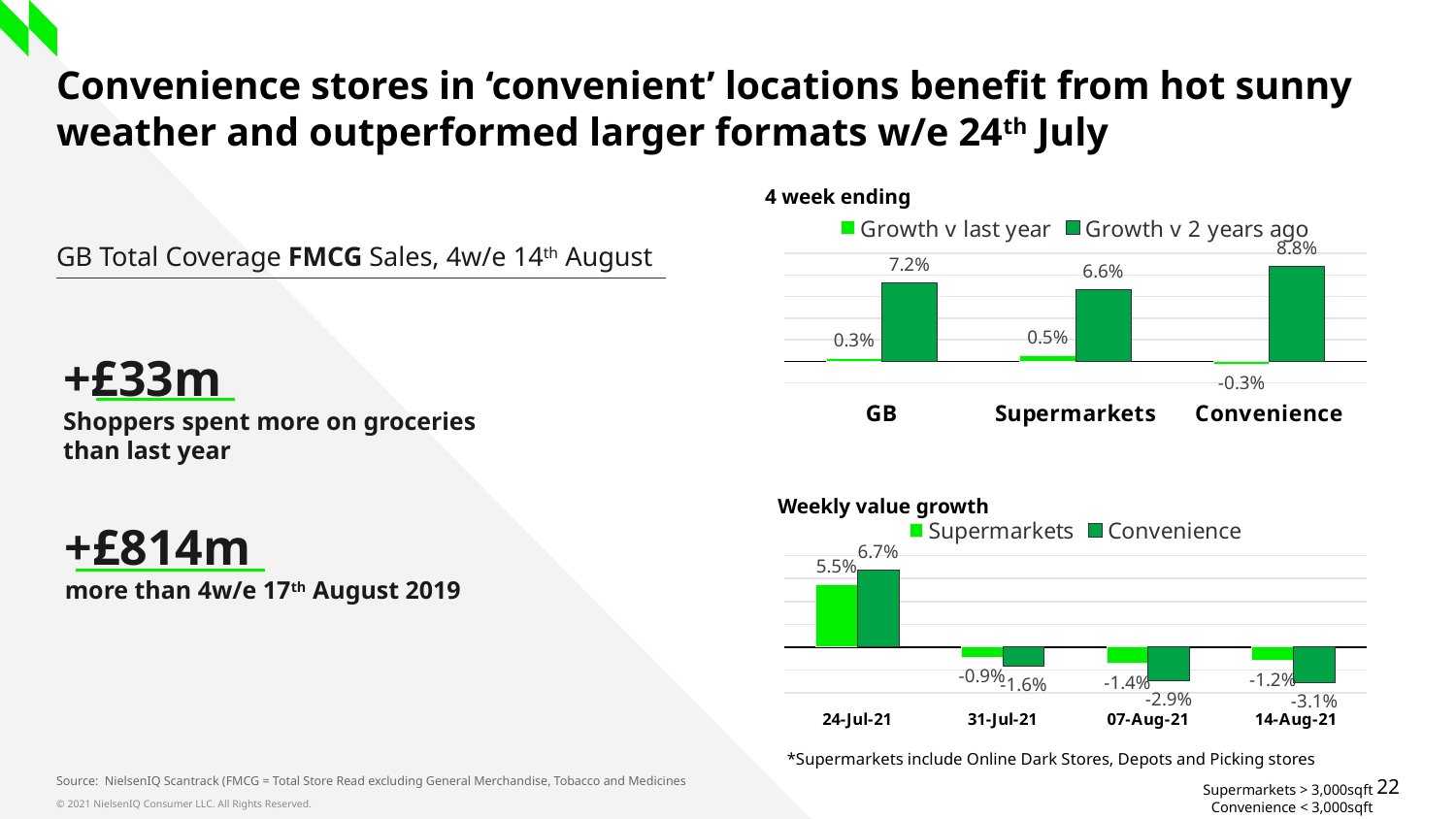
In the 'Weekly value growth' chart, which week has the lowest Convenience value? 14-Aug-21 In the '4 week ending' chart, what is the Growth v 2 years ago value for Convenience? 8.8% In the 'Weekly value growth' chart, is the Supermarkets value for 31-Jul-21 larger or smaller than the Convenience value for the same week? larger In the '4 week ending' chart, which category has the lowest Growth v last year value? Convenience In the 'Weekly value growth' chart, how many weeks are shown on the x axis? 4 In the '4 week ending' chart, what is the difference between the Growth v 2 years ago values for Convenience and Supermarkets? 2.2% In the 'Weekly value growth' chart, what is the Supermarkets value for 07-Aug-21? -1.4% In the '4 week ending' chart, how many series does the legend list? 2 In the '4 week ending' chart, what is the Growth v last year value for Supermarkets? 0.5% In the '4 week ending' chart, which category has the highest Growth v 2 years ago value? Convenience In the 'Weekly value growth' chart, what is the Convenience value for 24-Jul-21? 6.7% What type of chart is the 'Weekly value growth' chart? bar chart